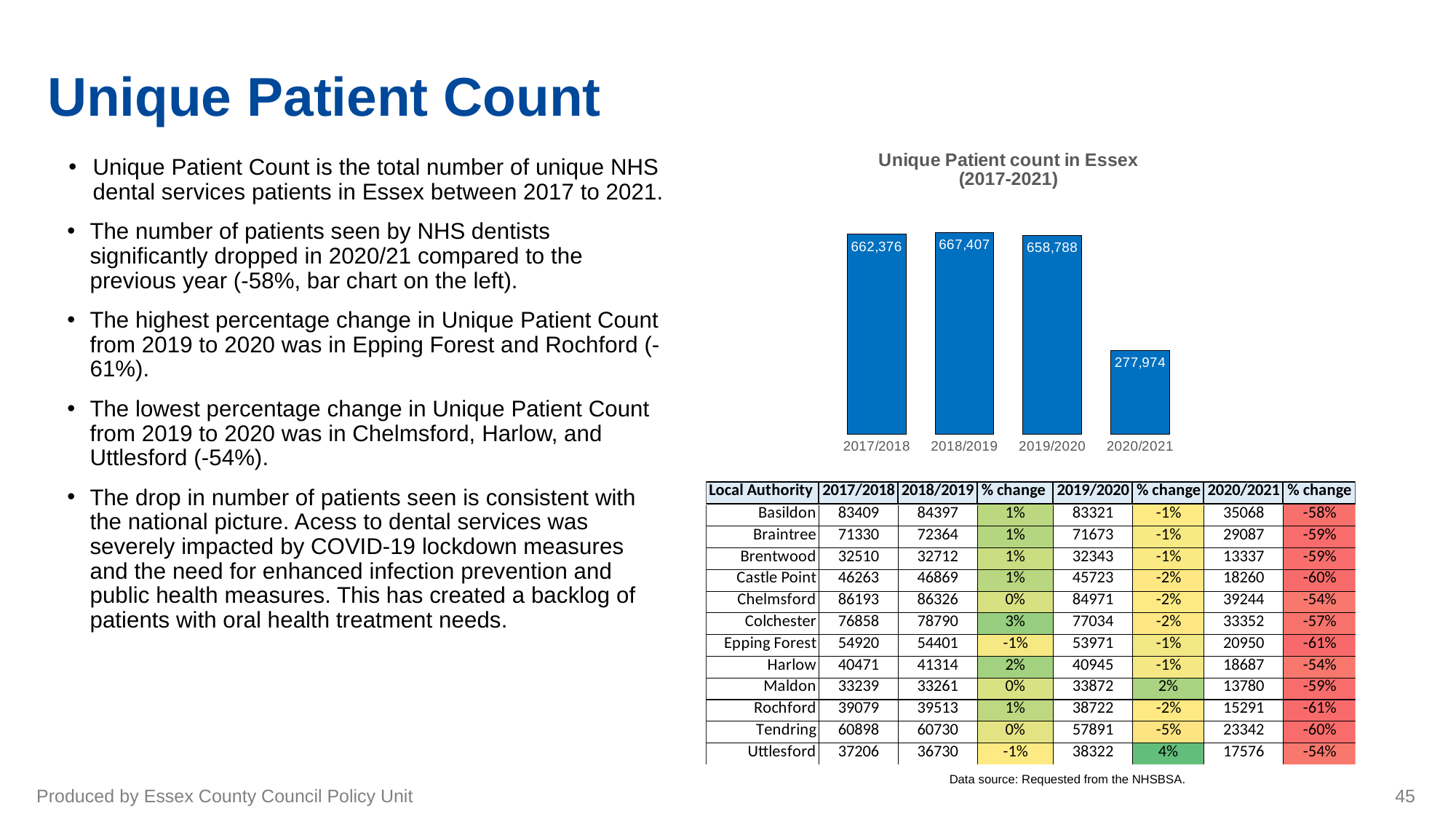
How many years are shown in the bar chart? 4 What is the unique patient count for 2020/2021? 277,974 What is the unique patient count for 2019/2020? 658,788 Which year has the lowest unique patient count in the bar chart? 2020/2021 What is the difference between the unique patient count in 2019/2020 and 2020/2021? 380,814 What is the difference between the unique patient count in 2018/2019 and 2017/2018? 5,031 What is the unique patient count for 2018/2019? 667,407 What type of chart is used to show the unique patient count in Essex? Bar chart What is the title of the chart? Unique Patient count in Essex (2017-2021) Which is larger, the unique patient count for 2017/2018 or for 2018/2019? 2018/2019 What is the unique patient count for 2017/2018? 662,376 Which year has the highest unique patient count in the bar chart? 2018/2019